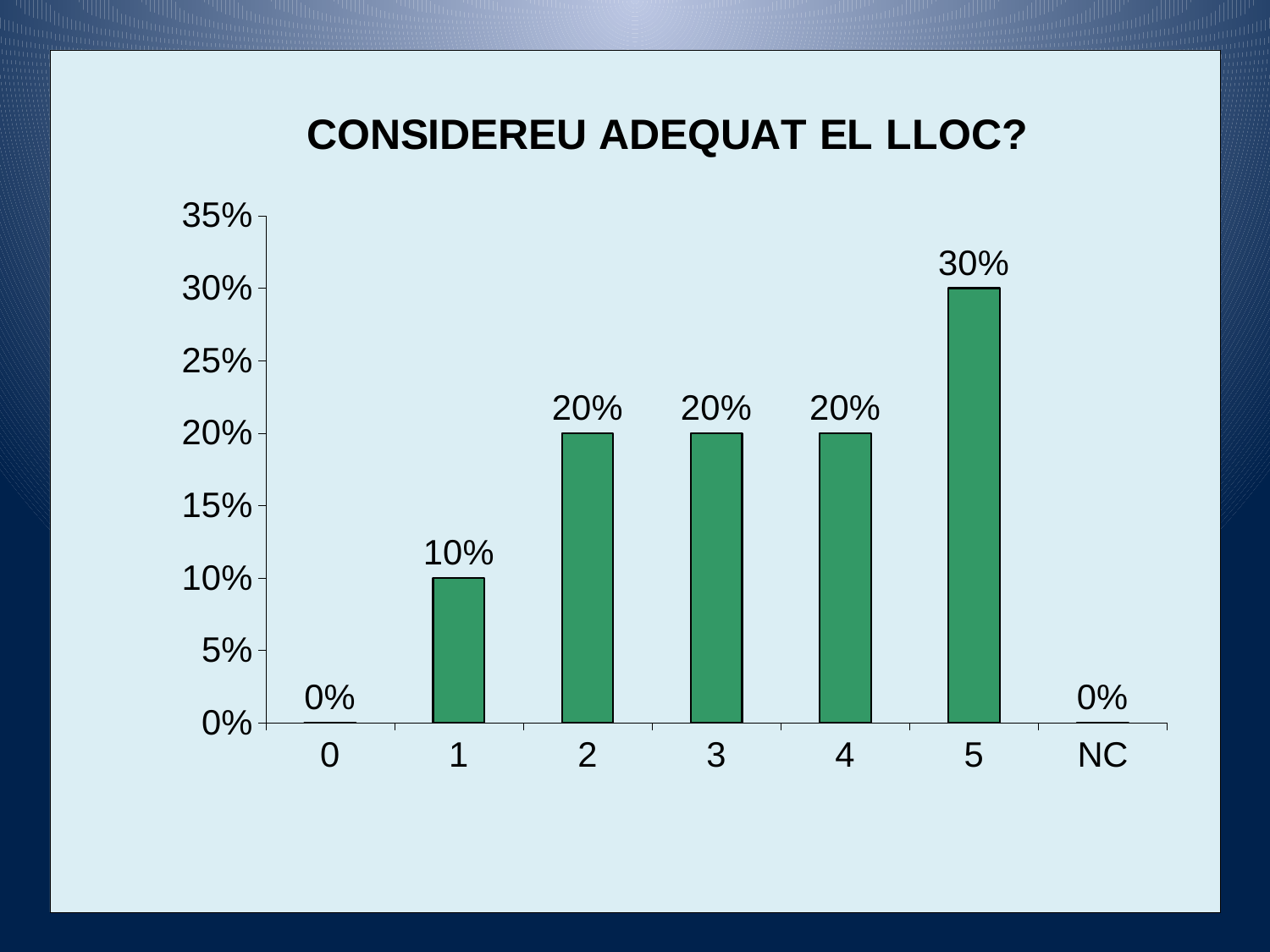
Which is larger, the value for category 3 or the value for category 5? 5 Is the value for category 5 greater or less than 25%? greater How many categories are shown on the x axis? 7 What is the value for category 5? 30% What kind of chart is this? bar chart How many categories have a value of 20%? 3 Which category has the highest value? 5 What is the value for category 1? 10% What is the difference between the values for category 5 and category 1? 20% What is the value for NC? 0% What colour are the bars? green What is the title of the chart? CONSIDEREU ADEQUAT EL LLOC?